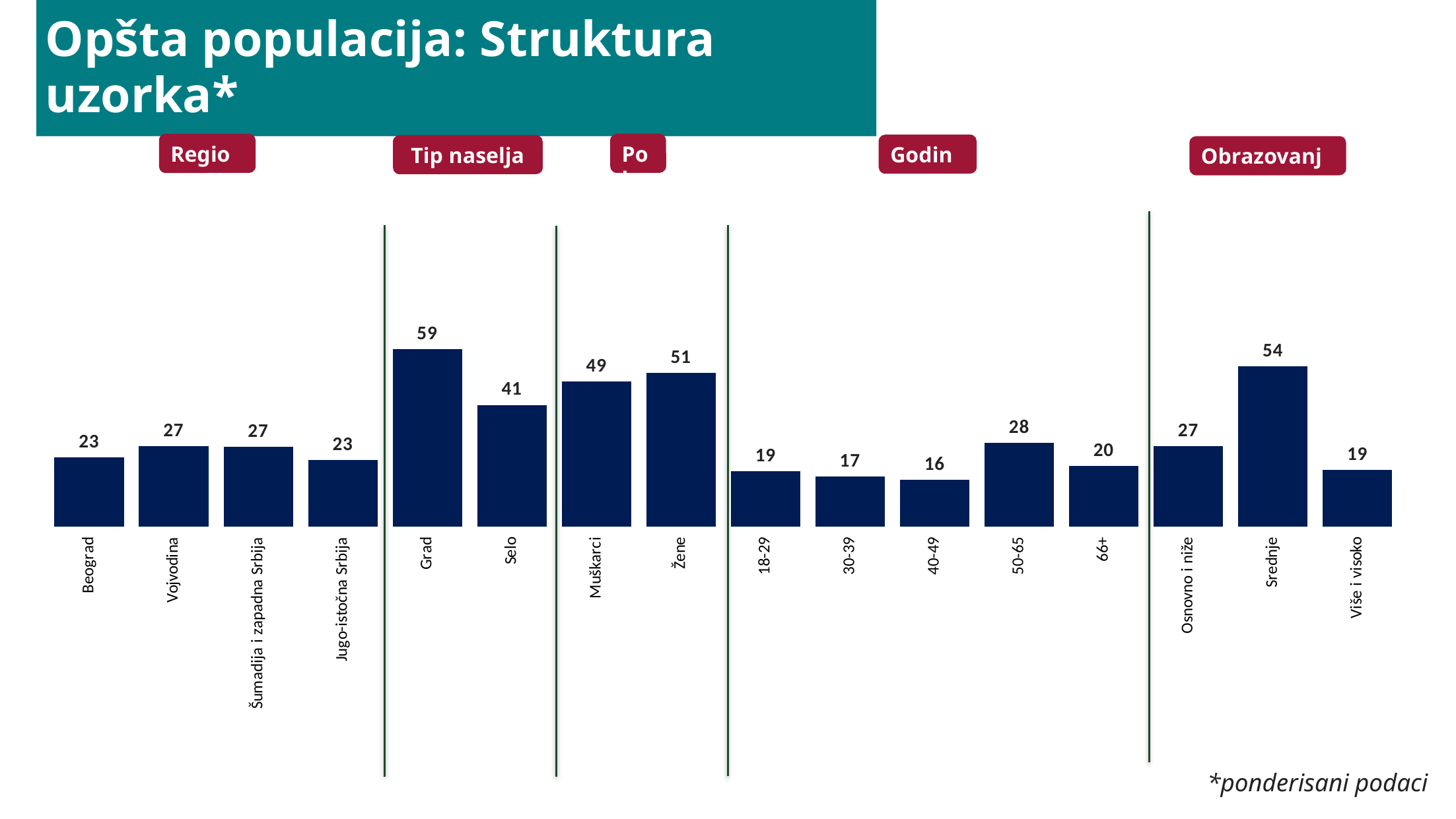
What is the difference between the values for Srednje and Više i visoko? 35 What is the value for the 40-49 age group? 16 What is the difference between the values for Grad and Selo? 18 What kind of chart is shown on the slide? Bar chart What is the value for Srednje? 54 What is the value for Grad? 59 Which category has the highest value on the chart? Grad What is the total of the values for Beograd, Vojvodina, Šumadija i zapadna Srbija and Jugo-istočna Srbija? 100 Which is larger, the value for Muškarci or the value for Žene? Žene Which age group has the lowest value? 40-49 How many bars are plotted on the chart? 16 What is the value for Žene? 51